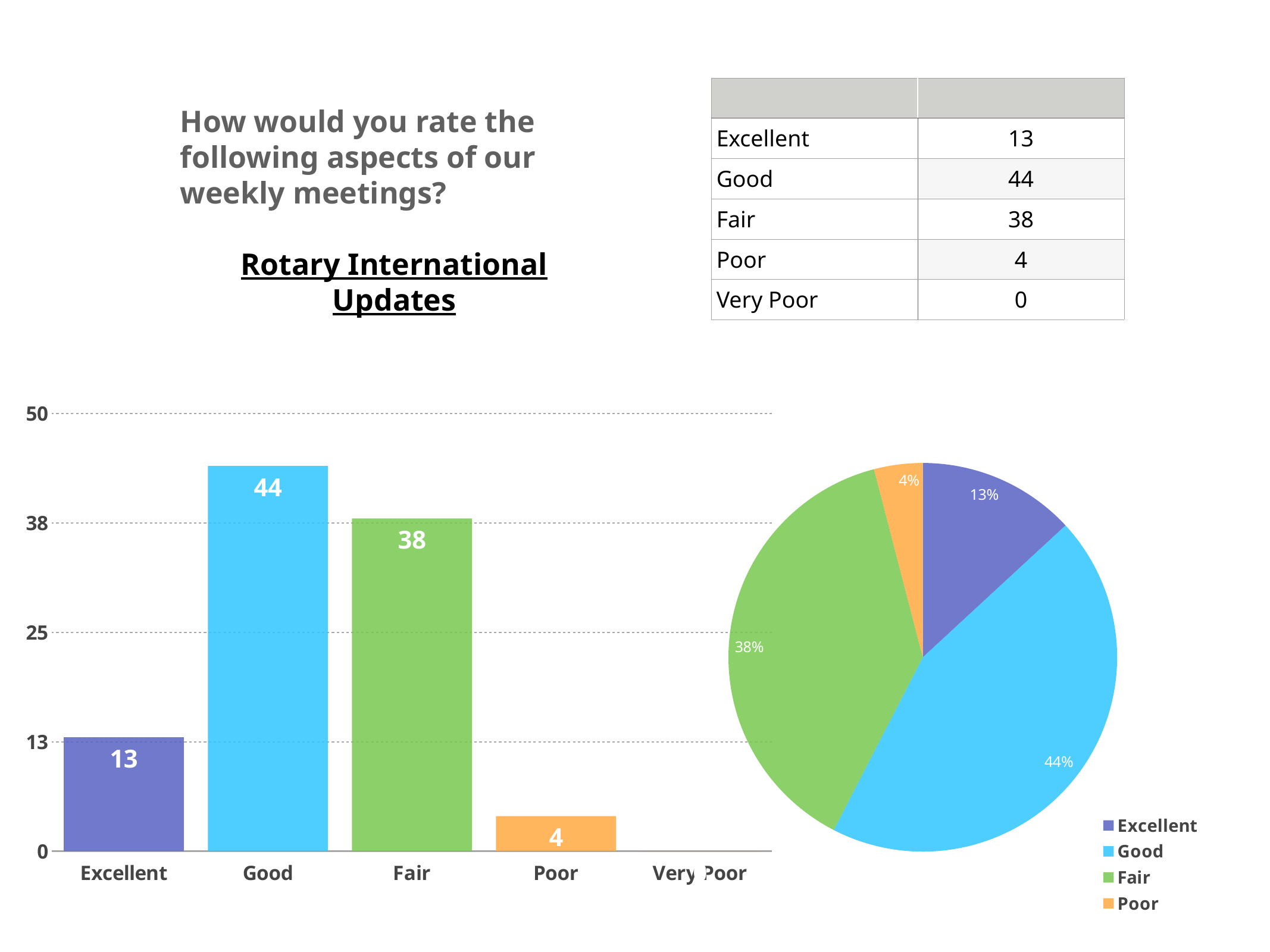
In the bar chart on the left, what is the value for Excellent? 13 In the bar chart on the left, which category has the lowest value? Very Poor In the bar chart on the left, what is the difference between the values for Good and Fair? 6 In the pie chart on the right, what share does the Fair slice have? 38% In the bar chart on the left, what is the value for Good? 44 In the bar chart on the left, which is larger, the value for Excellent or the value for Poor? Excellent In the pie chart on the right, which slice is the largest? Good In the bar chart on the left, which category has the highest value? Good What kind of chart is the chart on the left? bar chart How many entries does the legend of the pie chart on the right list? 4 How many categories are shown on the x axis of the bar chart on the left? 5 In the bar chart on the left, is the value for Fair greater or less than 25? greater